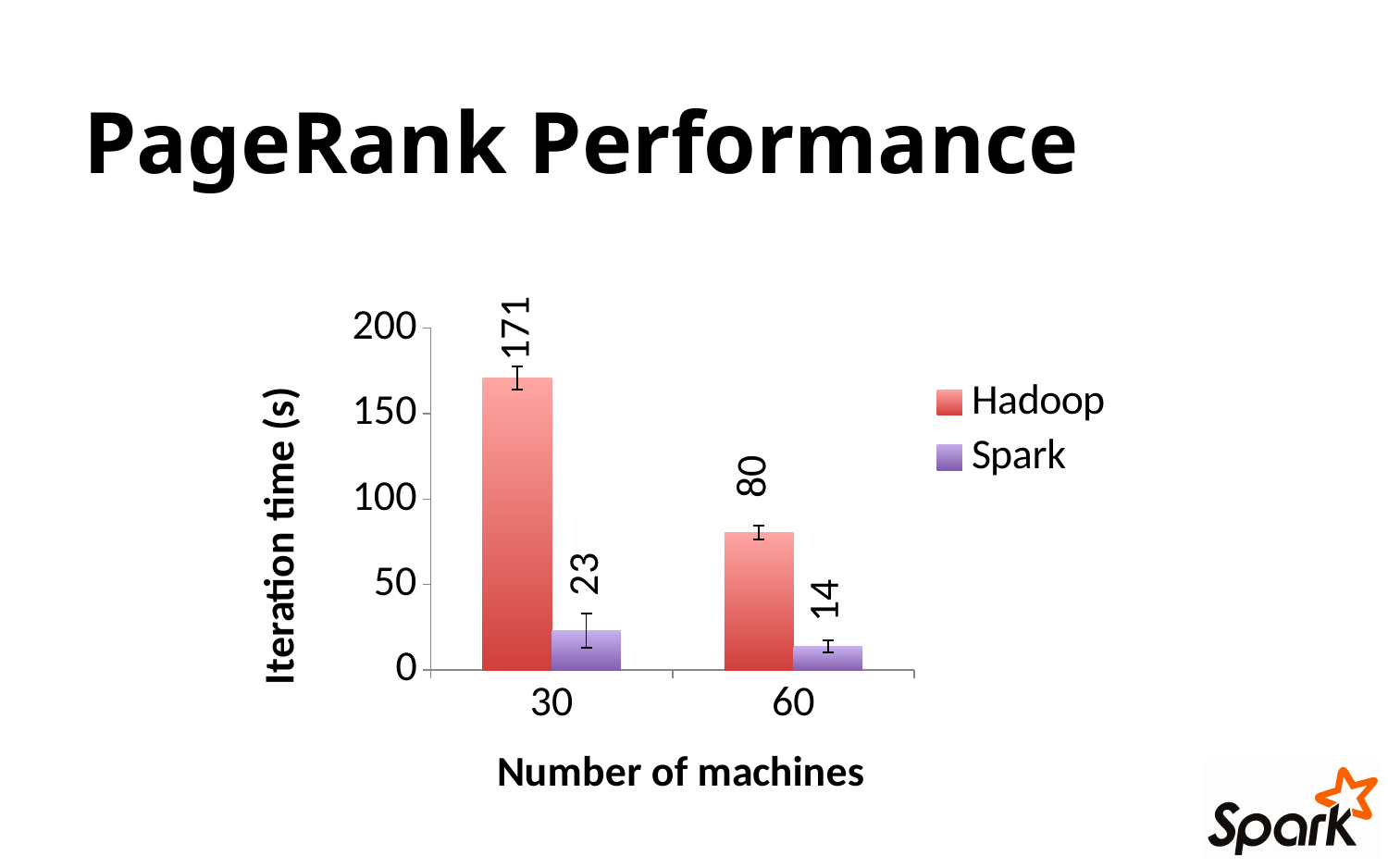
Which bar has the lowest iteration time? Spark with 60 machines Which bar has the highest iteration time? Hadoop with 30 machines Which has a larger iteration time at 60 machines, Hadoop or Spark? Hadoop Does the Hadoop iteration time rise or fall as the number of machines increases from 30 to 60? Fall What is the iteration time for Spark with 60 machines? 14 What is the iteration time for Hadoop with 30 machines? 171 What is the iteration time for Hadoop with 60 machines? 80 What kind of chart is shown on the slide? Bar chart How many series does the legend list? 2 What is the difference in iteration time between Hadoop and Spark at 30 machines? 148 How many categories are shown on the x axis? 2 What is the iteration time for Spark with 30 machines? 23